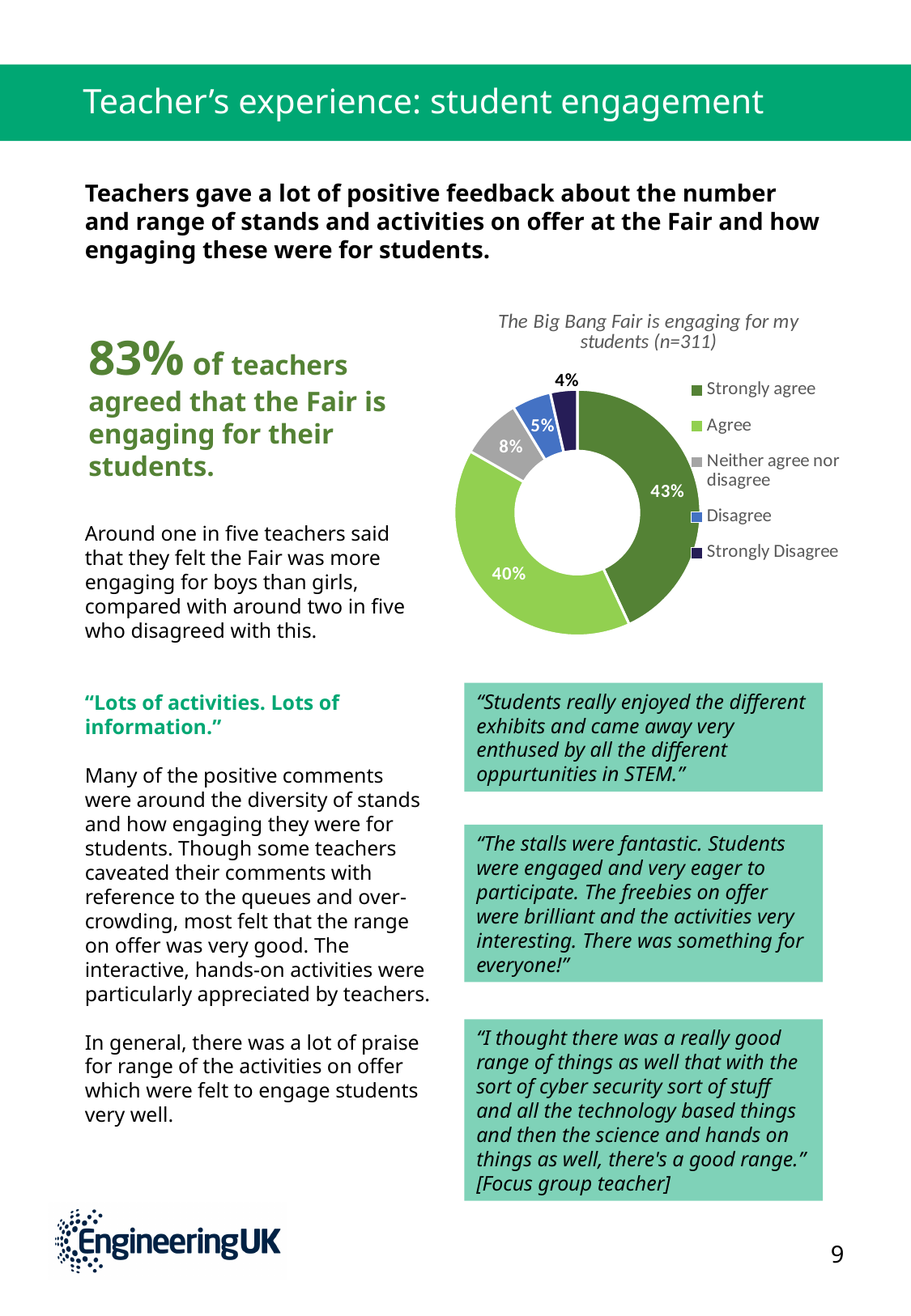
What type of chart is used to show the responses? Pie chart (doughnut) What percentage of teachers disagree that the Fair is engaging for their students? 5% How many response categories does the chart show? 5 What percentage of teachers neither agree nor disagree that the Fair is engaging for their students? 8% Which response category has the largest share of the chart? Strongly agree What is the sample size (n) given in the chart title? 311 What is the difference in percentage points between Strongly agree and Agree? 3 What percentage of teachers strongly agree that the Big Bang Fair is engaging for their students? 43% Which response category has the smallest share of the chart? Strongly Disagree What percentage of teachers strongly disagree that the Fair is engaging for their students? 4% Which is larger: the share for Neither agree nor disagree or the share for Disagree? Neither agree nor disagree What percentage of teachers agree that the Big Bang Fair is engaging for their students? 40%